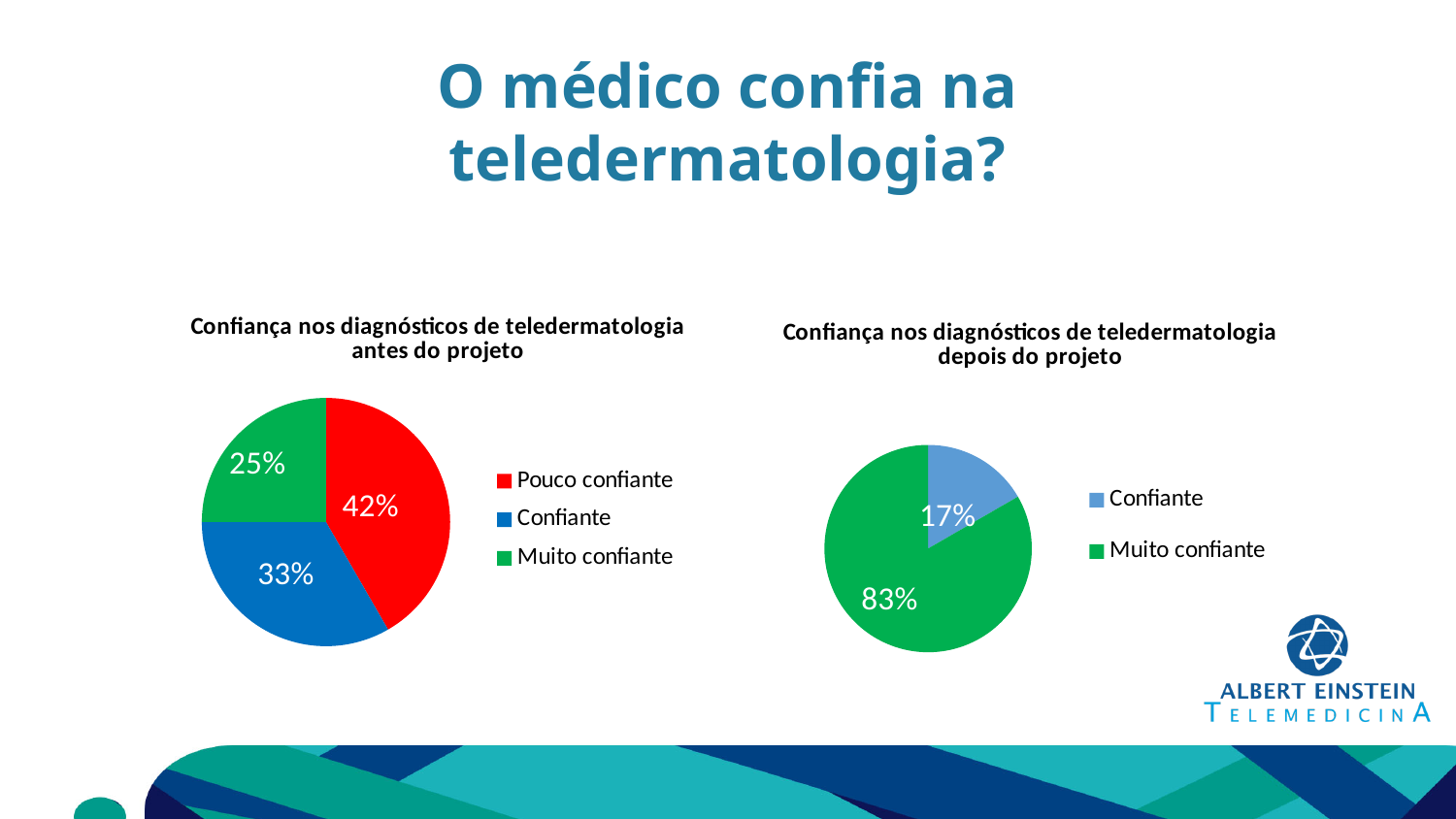
In the chart 'Confiança nos diagnósticos de teledermatologia antes do projeto', what is the value for 'Pouco confiante'? 42% In the chart 'Confiança nos diagnósticos de teledermatologia depois do projeto', what is the value for 'Muito confiante'? 83% In the chart 'Confiança nos diagnósticos de teledermatologia antes do projeto', which category has the smallest share? Muito confiante In the chart 'Confiança nos diagnósticos de teledermatologia antes do projeto', which is larger: 'Confiante' or 'Muito confiante'? Confiante In the chart 'Confiança nos diagnósticos de teledermatologia antes do projeto', which category has the largest share? Pouco confiante In the chart 'Confiança nos diagnósticos de teledermatologia antes do projeto', what is the difference between 'Pouco confiante' and 'Confiante'? 9% What kind of chart is 'Confiança nos diagnósticos de teledermatologia depois do projeto'? Pie chart In the chart 'Confiança nos diagnósticos de teledermatologia depois do projeto', what is the difference between 'Muito confiante' and 'Confiante'? 66% In the chart 'Confiança nos diagnósticos de teledermatologia antes do projeto', what is the value for 'Muito confiante'? 25% How many categories does the chart 'Confiança nos diagnósticos de teledermatologia antes do projeto' show? 3 In the chart 'Confiança nos diagnósticos de teledermatologia depois do projeto', what is the value for 'Confiante'? 17% How many categories does the chart 'Confiança nos diagnósticos de teledermatologia depois do projeto' show? 2